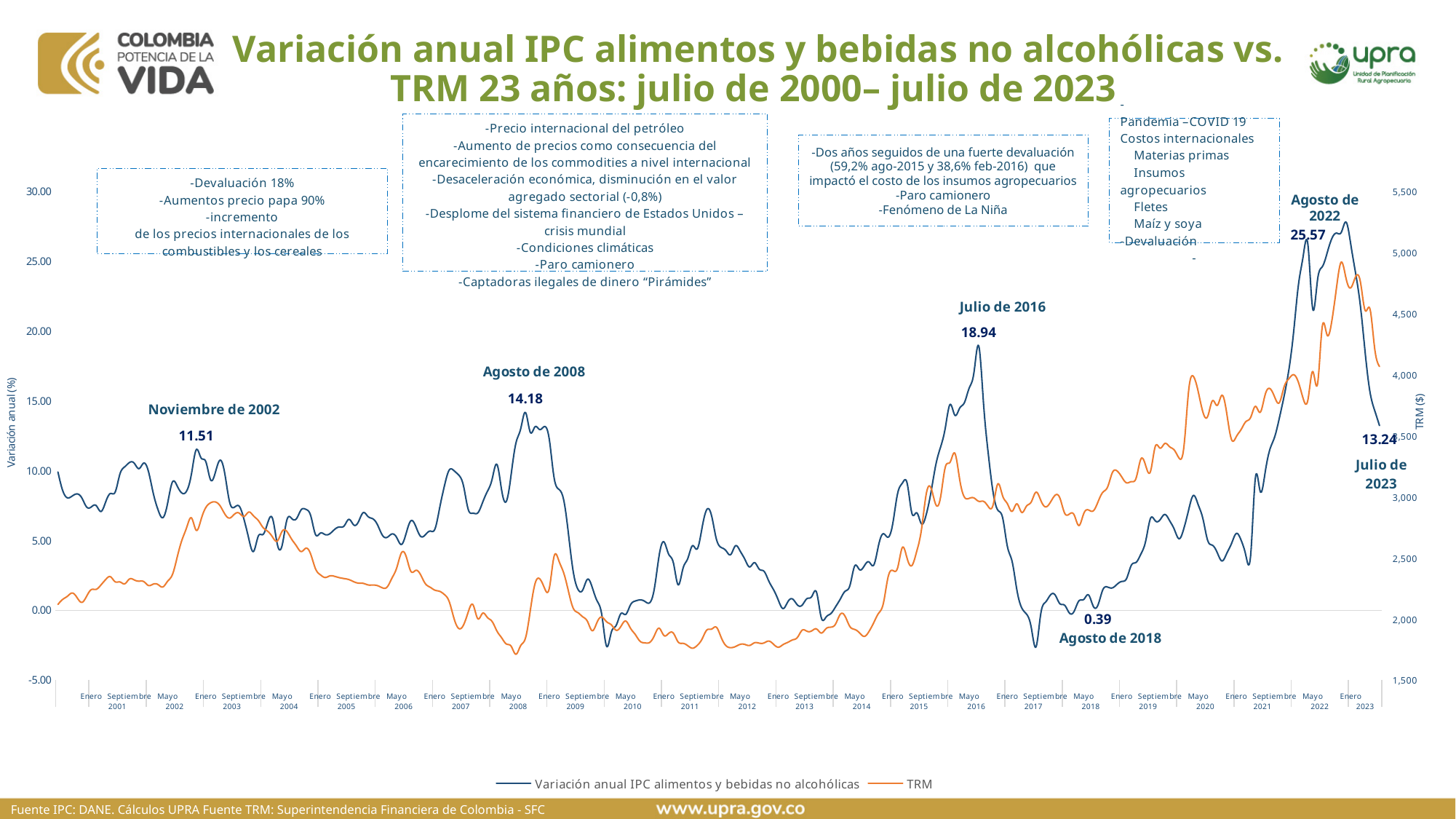
What is the labelled value of the annual IPC variation for Julio de 2023? 13.24 What is the labelled value of the annual IPC variation for Agosto de 2022? 25.57 Which series is drawn in orange according to the legend? TRM How many series does the legend list? 2 What is the difference between the labelled IPC values for Agosto de 2022 and Julio de 2023? 12.33 What is the labelled value of the annual IPC variation for Noviembre de 2002? 11.51 What is the labelled value of the annual IPC variation for Agosto de 2018? 0.39 What kind of chart is shown on the slide? line chart Which labelled point on the IPC line has the highest value? Agosto de 2022 Which labelled point on the IPC line has the lowest value? Agosto de 2018 Which labelled IPC value is larger, Agosto de 2008 or Julio de 2016? Julio de 2016 What is the labelled value of the annual IPC variation for Julio de 2016? 18.94